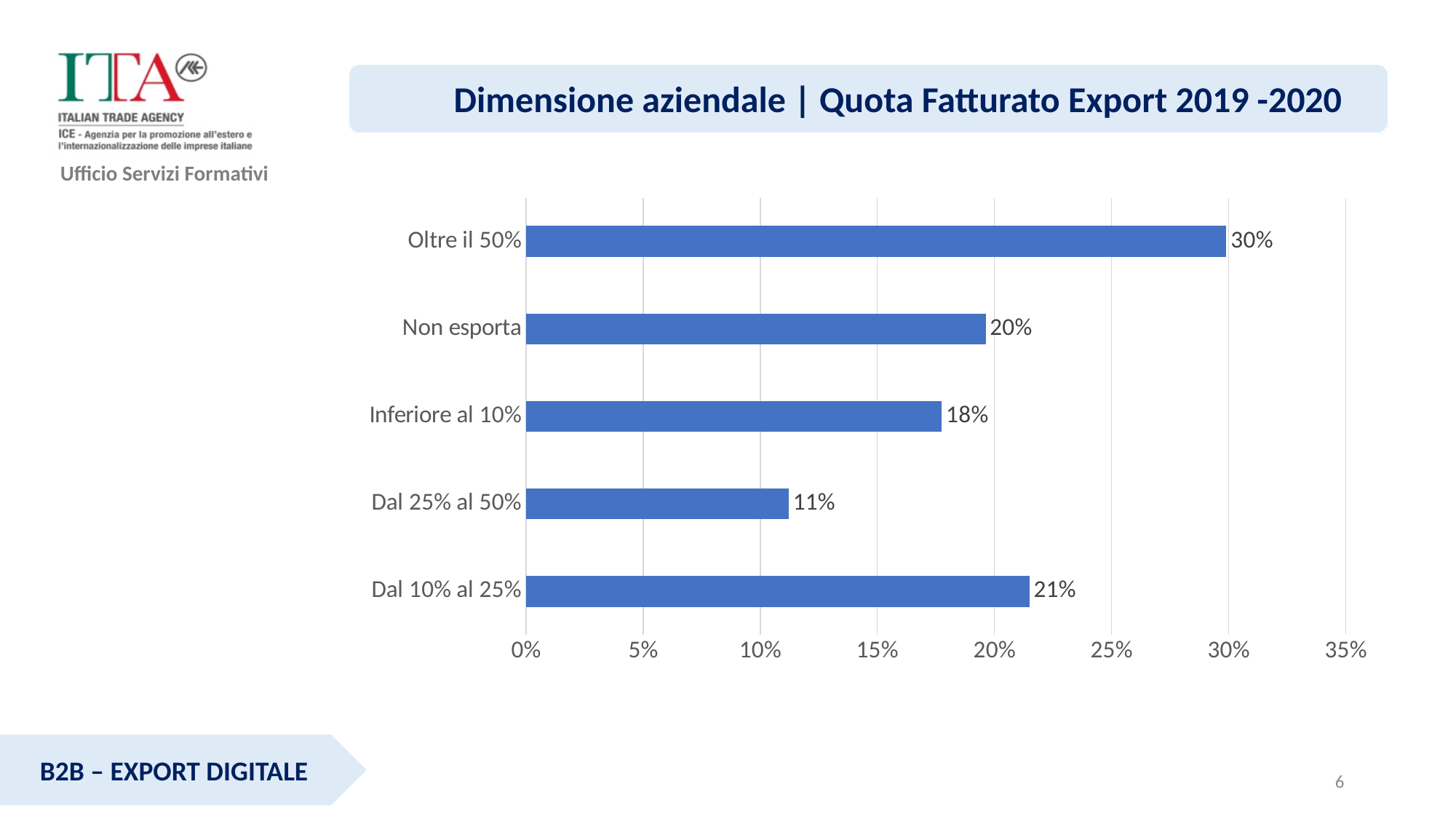
What is the value for "Non esporta"? 20% Is the value for "Non esporta" greater or less than 25%? less What is the title of the slide containing the chart? Dimensione aziendale | Quota Fatturato Export 2019 -2020 Which category has the lowest value? Dal 25% al 50% What kind of chart is shown on the slide? bar chart What is the value for "Dal 25% al 50%"? 11% Which category has the highest value? Oltre il 50% What is the difference between the values for "Oltre il 50%" and "Inferiore al 10%"? 12% How many categories are shown in the chart? 5 Which is larger, the value for "Dal 10% al 25%" or the value for "Inferiore al 10%"? Dal 10% al 25% What is the value for "Dal 10% al 25%"? 21% What is the value for "Oltre il 50%"? 30%